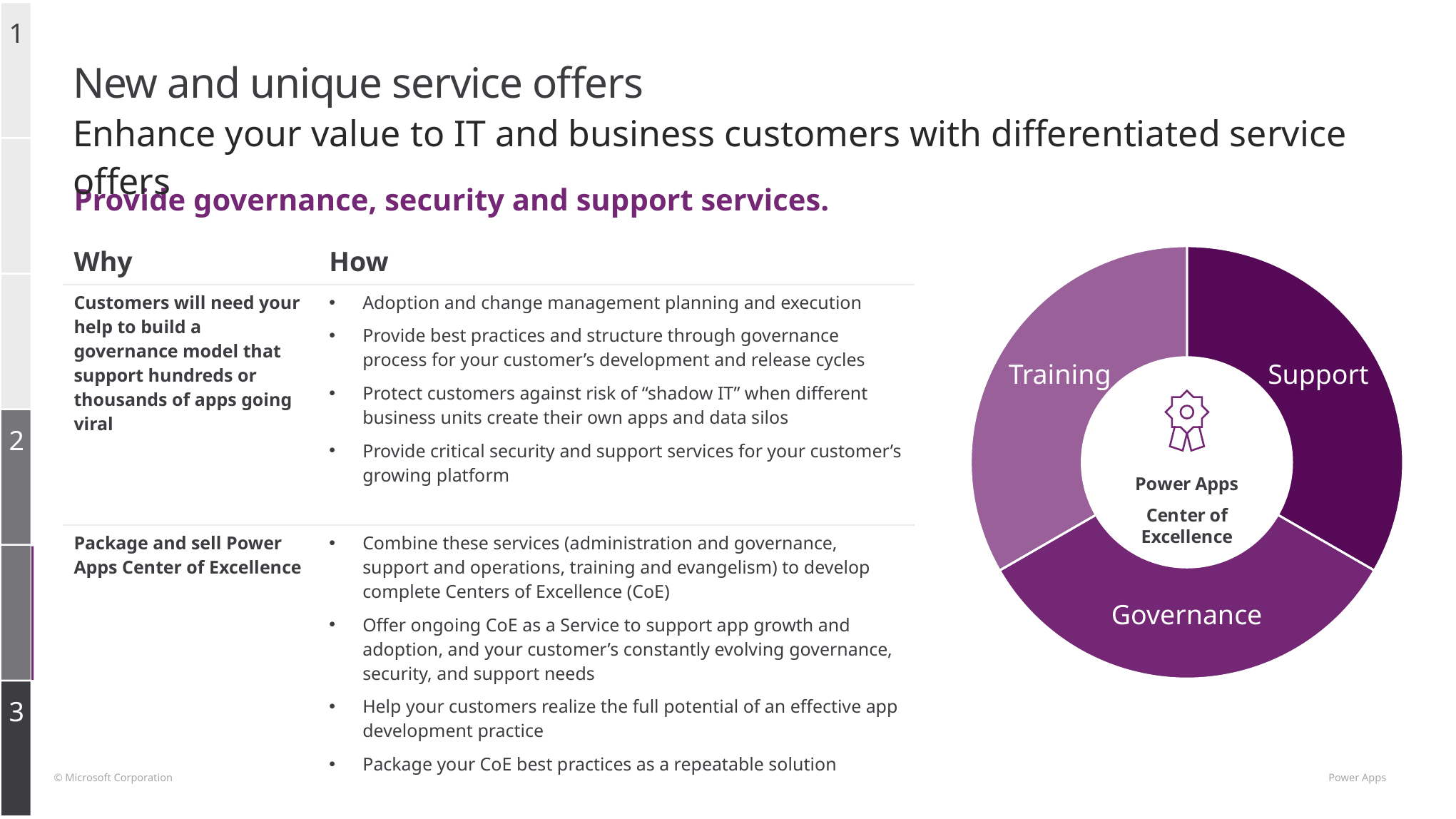
Which segment of the donut chart is the lightest shade of purple? Training What are the three segments of the donut chart labelled? Training, Support, Governance How many segments does the donut chart have? 3 What kind of chart is shown on the right side of the slide? Donut chart Which segment of the donut chart is labelled at the bottom? Governance What text appears in the centre of the donut chart? Power Apps Center of Excellence